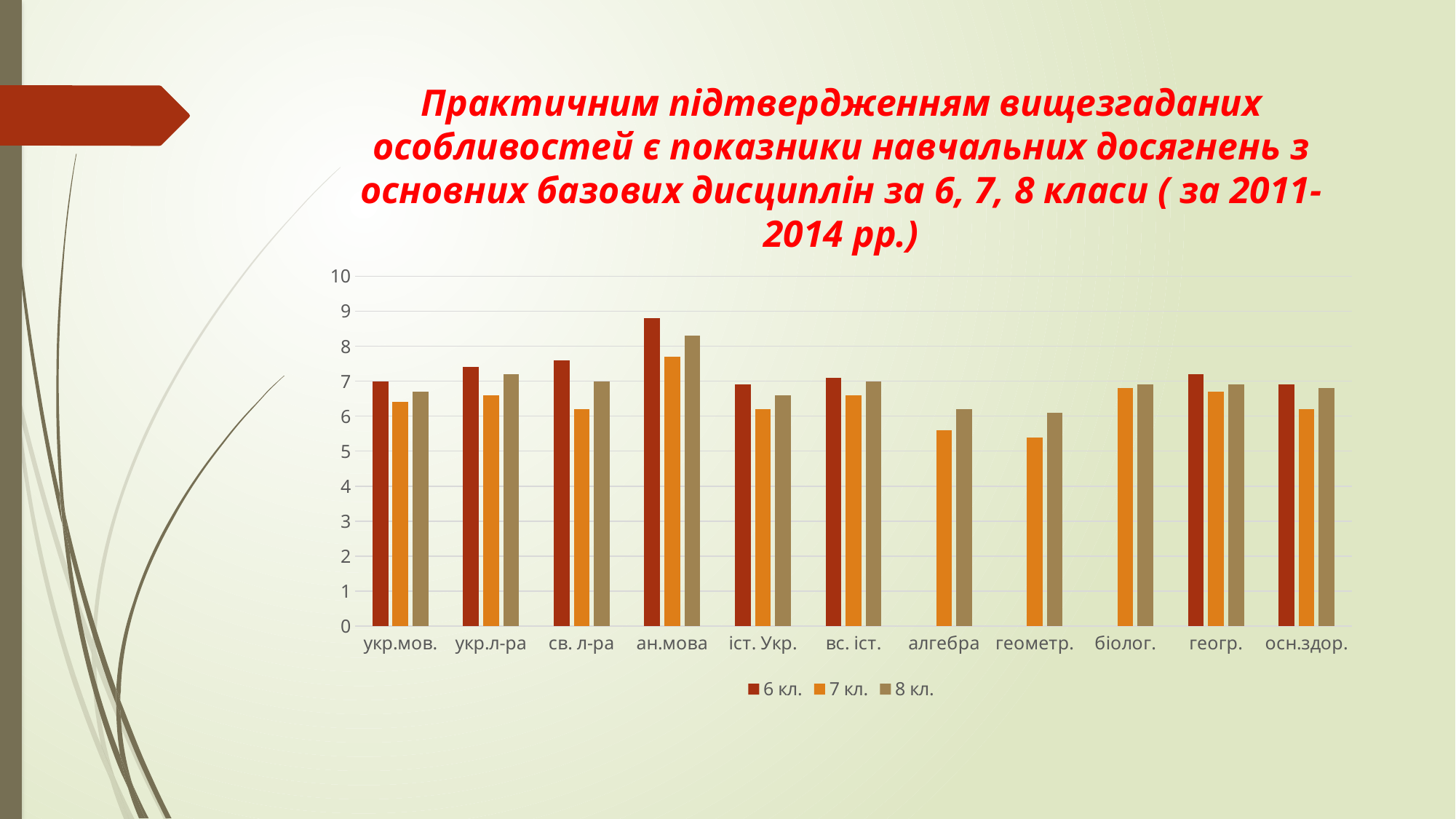
In ан.мова, which is larger: the value for 6 кл. or for 7 кл.? 6 кл. How many series does the legend list? 3 What are the three entries listed in the legend? 6 кл., 7 кл., 8 кл. In геометр., which is larger: the value for 7 кл. or for 8 кл.? 8 кл. Is the value for 6 кл. in ан.мова greater or less than 8? greater What kind of chart is shown on the slide? bar chart Is the value for 6 кл. in св. л-ра greater or less than 7? greater Is the value for 7 кл. in алгебра greater or less than 6? less Which subject has the lowest bar for 7 кл.? геометр. Which subject has the highest bar for 6 кл.? ан.мова How many subject categories are shown on the x axis? 11